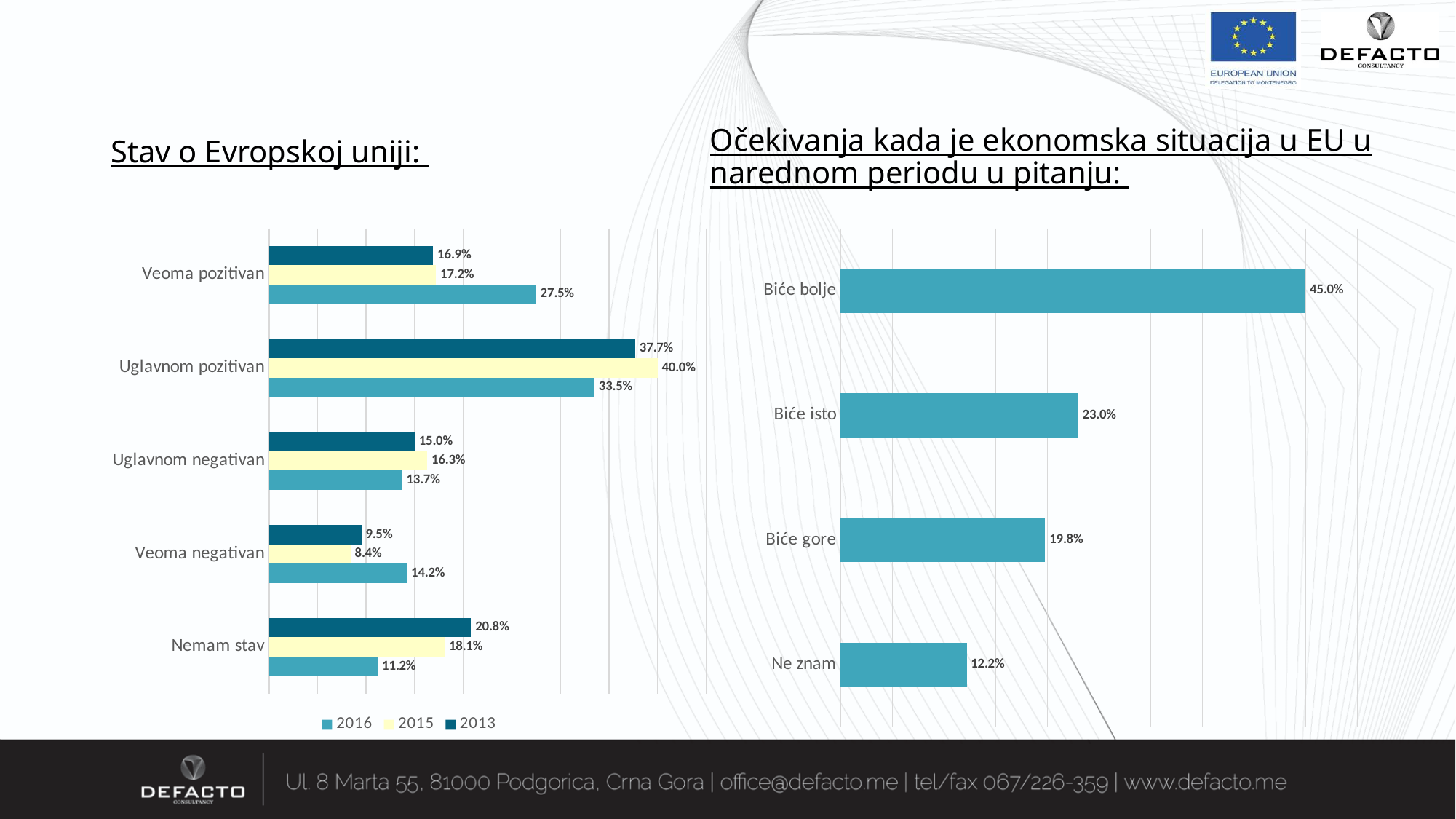
How many categories are shown in the chart titled "Stav o Evropskoj uniji"? 5 In the chart titled "Stav o Evropskoj uniji", which category has the highest 2016 value? Uglavnom pozitivan In the chart titled "Stav o Evropskoj uniji", which category has the lowest 2015 value? Veoma negativan In the chart titled "Stav o Evropskoj uniji", what is the difference between the 2016 and 2013 values for Veoma pozitivan? 10.6% In the chart titled "Stav o Evropskoj uniji", which is larger for Nemam stav: the 2015 value or the 2016 value? 2015 In the chart titled "Stav o Evropskoj uniji", what is the 2015 value for Uglavnom pozitivan? 40.0% In the chart titled "Stav o Evropskoj uniji", what is the 2013 value for Nemam stav? 20.8% What kind of chart is the chart on the right about expectations for the economic situation in the EU? Bar chart In the chart titled "Stav o Evropskoj uniji", what is the 2016 value for Veoma pozitivan? 27.5% How many series does the legend of the chart titled "Stav o Evropskoj uniji" list? 3 In the chart on the right about expectations for the economic situation in the EU, which category has the lowest value? Ne znam In the chart on the right about expectations for the economic situation in the EU, what is the value for Biće bolje? 45.0%